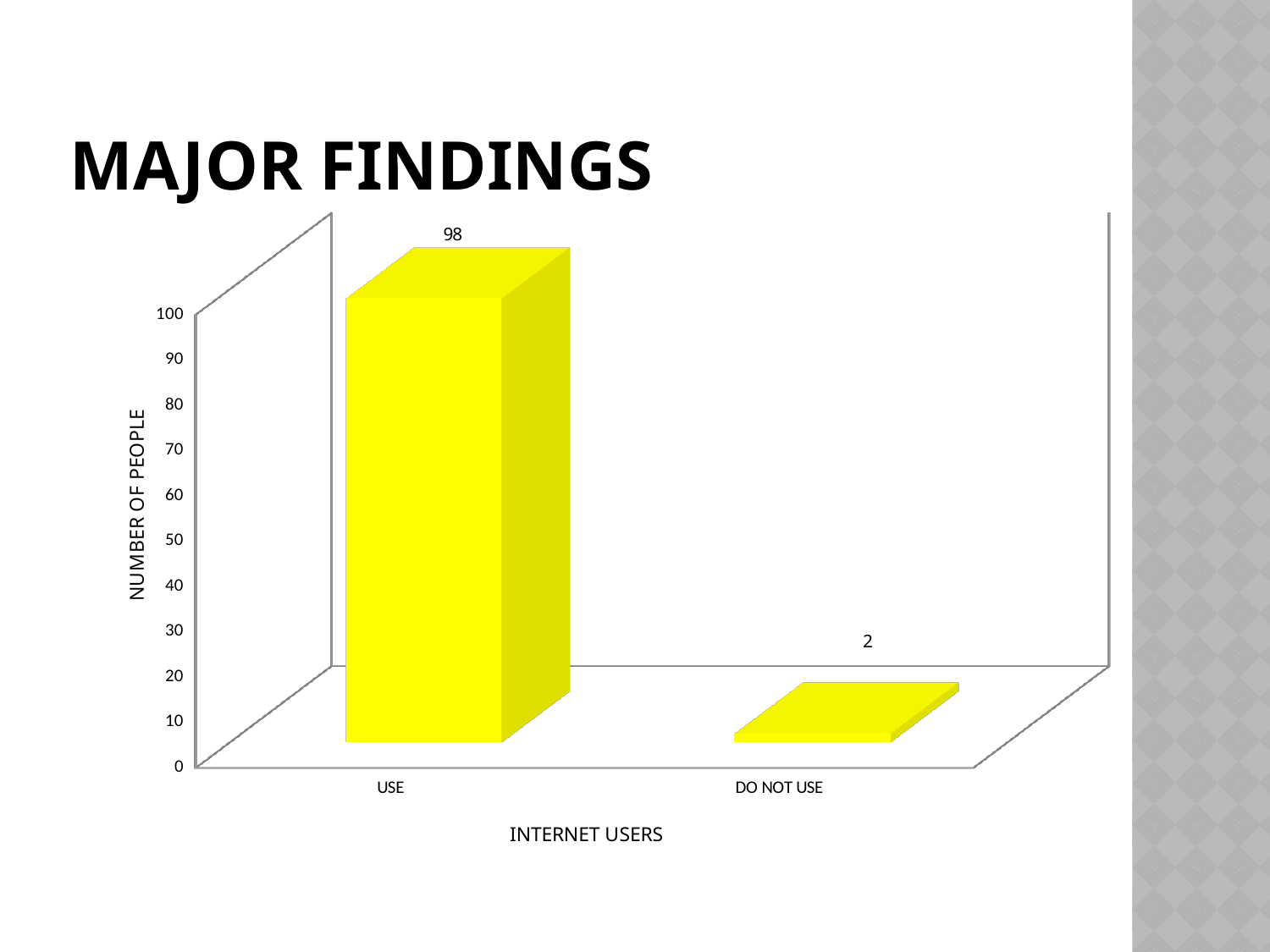
What is the label of the vertical axis? NUMBER OF PEOPLE Is the value for USE greater or less than 50? greater Is the value for DO NOT USE greater or less than 10? less What is the label of the horizontal axis? INTERNET USERS Which is larger, the value for USE or the value for DO NOT USE? USE What kind of chart is shown on the slide? bar chart What is the difference between the values for USE and DO NOT USE? 96 What is the value for USE? 98 What is the value for DO NOT USE? 2 How many categories are shown on the x axis? 2 Which category has the lowest value? DO NOT USE Which category has the highest value? USE